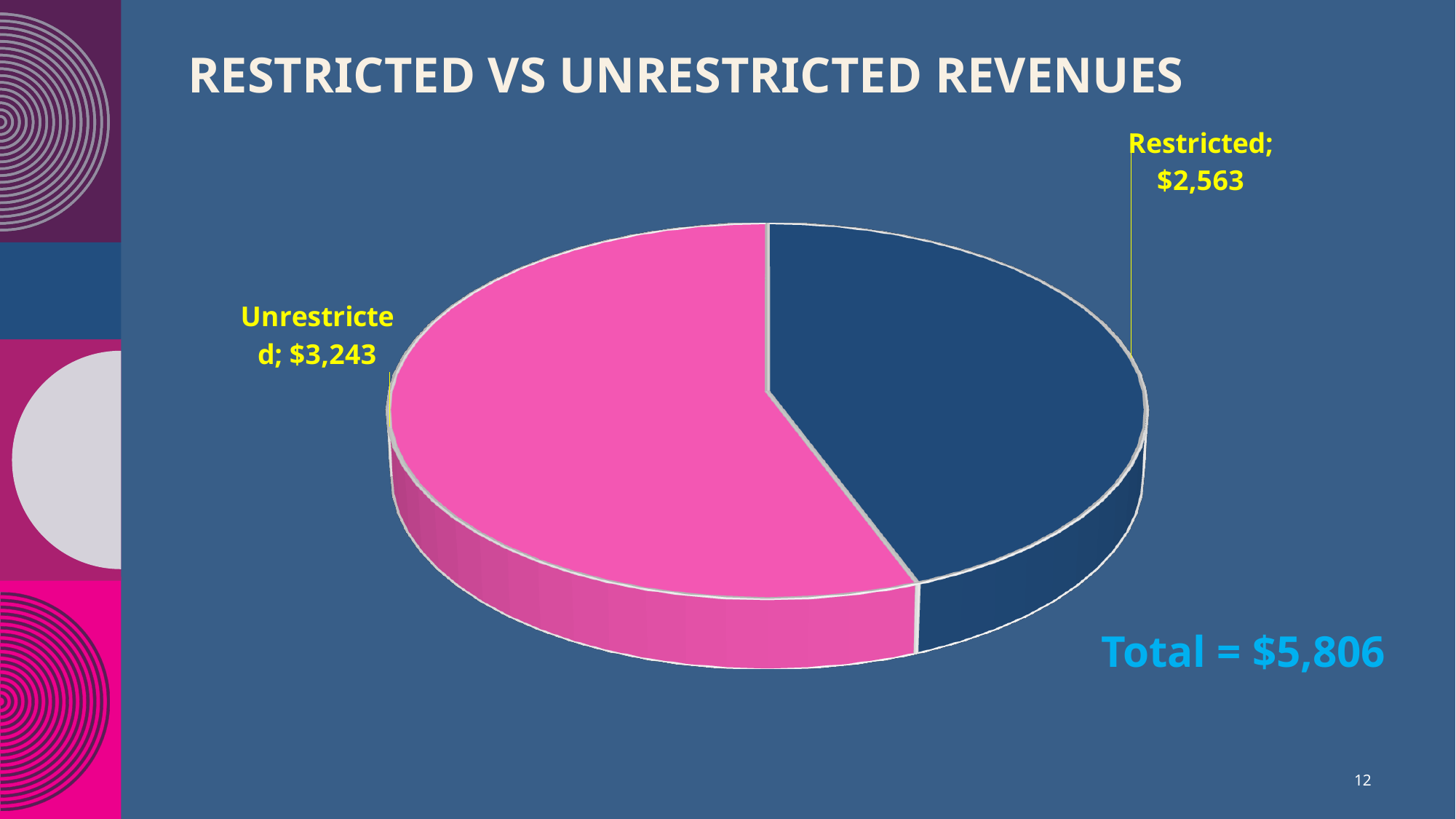
Which slice is the largest? Unrestricted Which is larger, Restricted or Unrestricted revenue? Unrestricted What share of the total does the Restricted slice represent, to the nearest whole percent? 44% How many slices does the pie chart have? 2 What is the value of the Restricted slice? $2,563 What is the difference between the Unrestricted and Restricted values? $680 What is the total of the two slices as stated on the slide? $5,806 Which slice is the smallest? Restricted What is the title of the chart? RESTRICTED VS UNRESTRICTED REVENUES What share of the total does the Unrestricted slice represent, to the nearest whole percent? 56% What kind of chart is shown on the slide? Pie chart What is the value of the Unrestricted slice? $3,243